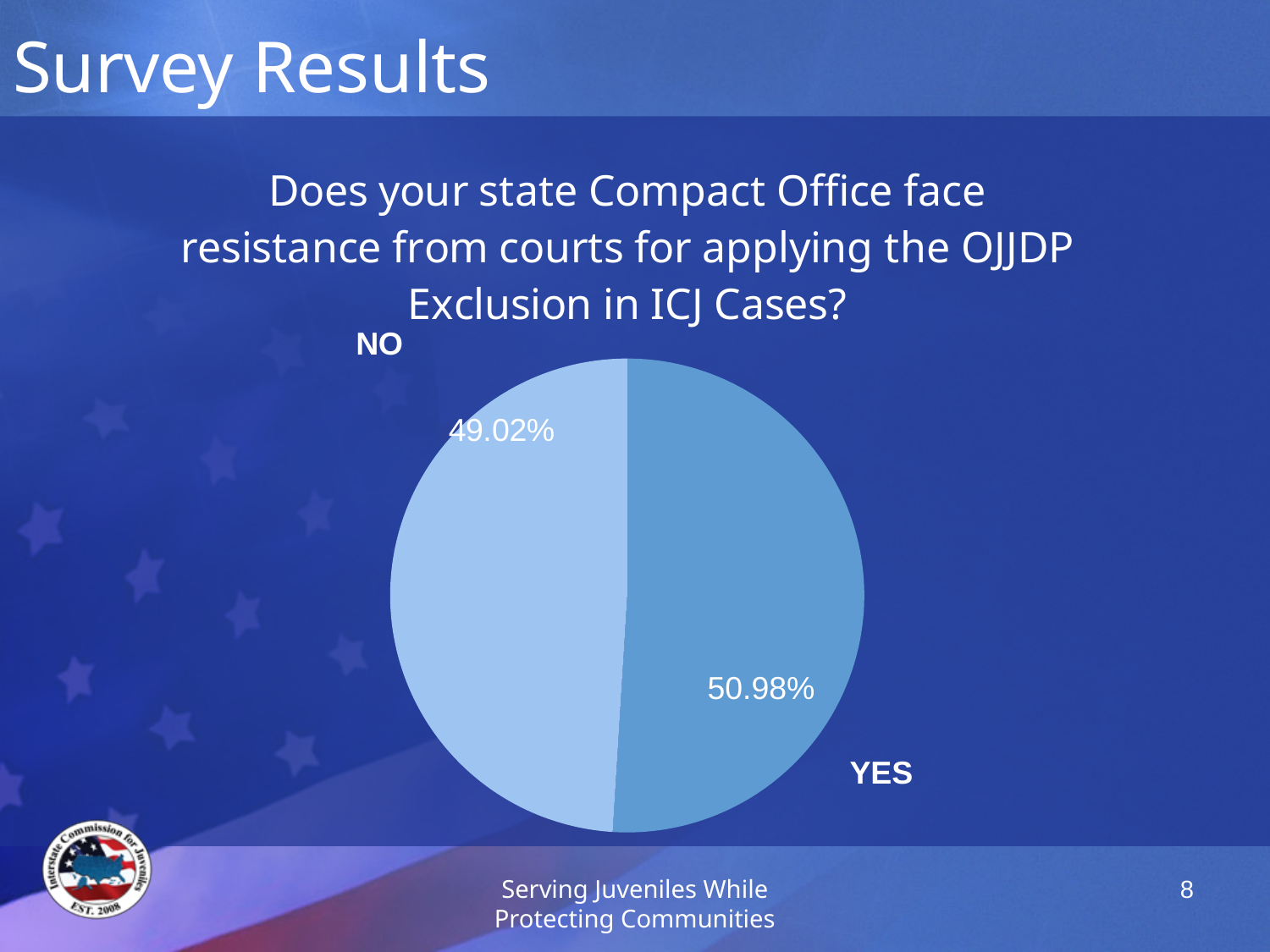
What is the difference in percentage points between the YES and NO shares? 1.96 Which slice is shown in the lighter blue colour, YES or NO? NO What percentage of respondents answered NO? 49.02% What kind of chart is shown on the slide? pie chart What survey question does the pie chart present results for? Does your state Compact Office face resistance from courts for applying the OJJDP Exclusion in ICJ Cases? Is the share for YES greater or less than 50%? greater How many slices does the pie chart have? 2 Is the share for NO greater or less than 50%? less Which response has the smallest share of the pie? NO What percentage of respondents answered YES? 50.98% Which response has the larger share of the pie, YES or NO? YES